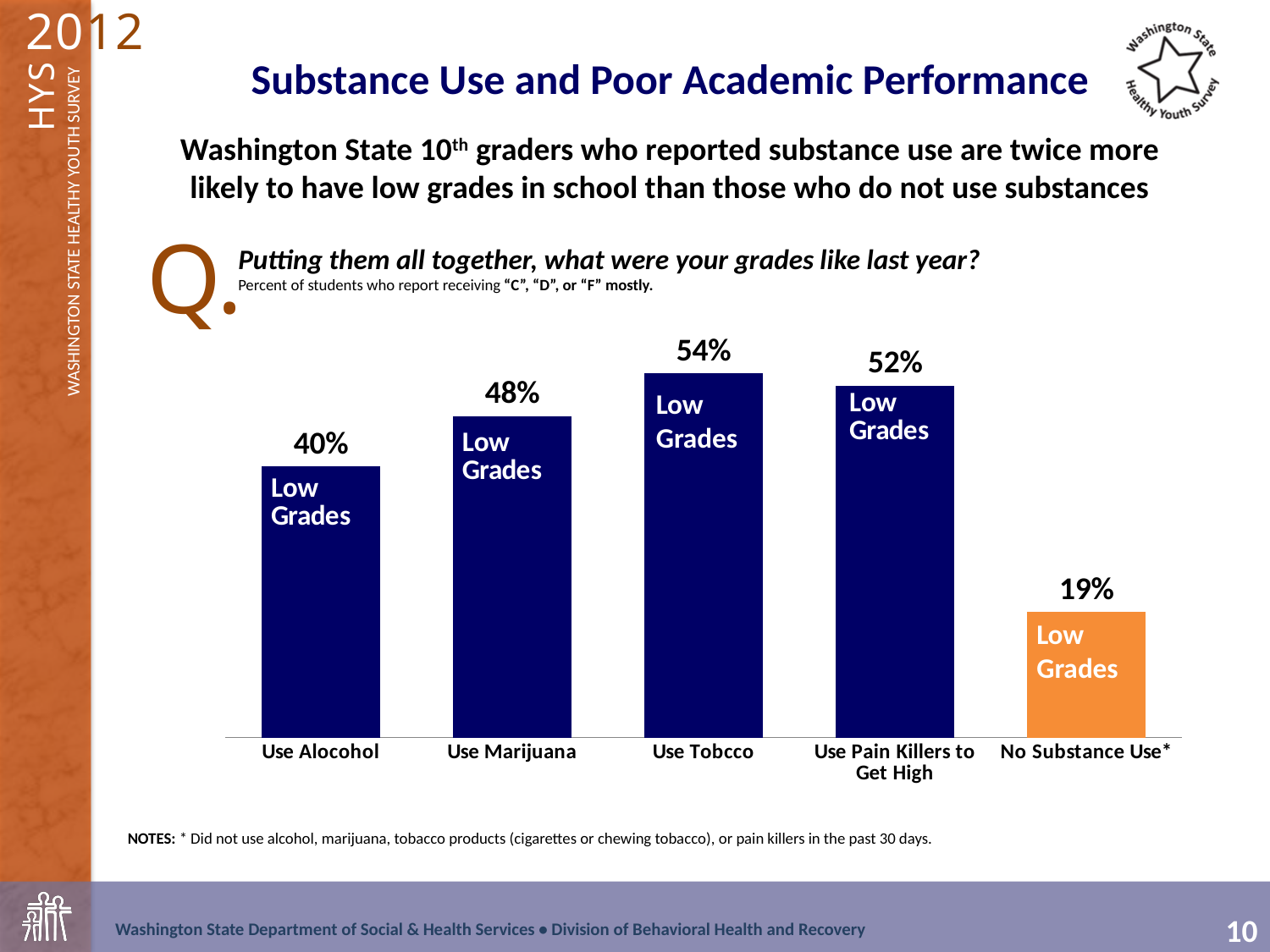
Which category has the highest percentage of students reporting low grades? Use Tobcco What kind of chart is shown on the slide? Bar chart What is the value shown for No Substance Use*? 19% What is the value shown for Use Tobcco? 54% Which category has the lowest percentage of students reporting low grades? No Substance Use* What is the difference in percentage points between Use Marijuana and Use Alocohol? 8 What is the value shown for Use Marijuana? 48% What is the difference in percentage points between Use Tobcco and No Substance Use*? 35 Which is larger, the value for Use Pain Killers to Get High or the value for Use Alocohol? Use Pain Killers to Get High What percentage of students who use alcohol report low grades? 40% How many categories are shown on the x axis of the chart? 5 What is the value shown for Use Pain Killers to Get High? 52%